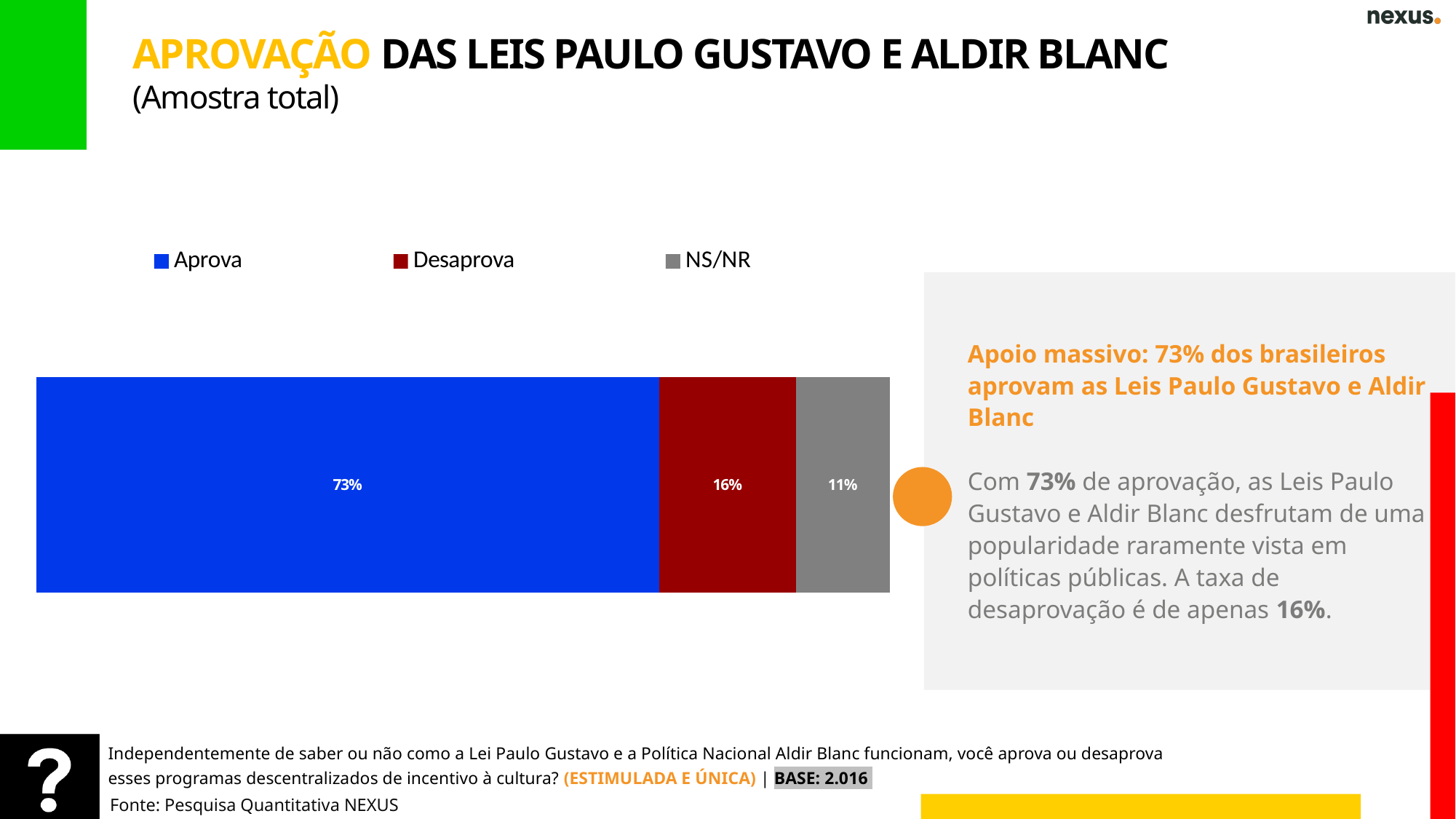
What percentage of respondents disapprove (Desaprova)? 16% What percentage of respondents approve (Aprova) the Paulo Gustavo and Aldir Blanc laws? 73% Which response category has the highest share? Aprova Which is larger, Desaprova or NS/NR? Desaprova Which response category has the lowest share? NS/NR What kind of chart is shown on the slide? Stacked bar chart What is the total of the three segments in the stacked bar? 100% What is the value shown for NS/NR? 11% What is the difference in percentage points between Aprova and Desaprova? 57 percentage points What colour represents the Desaprova series? Dark red What is the base (number of respondents) stated on the slide? 2.016 How many series does the legend list? 3